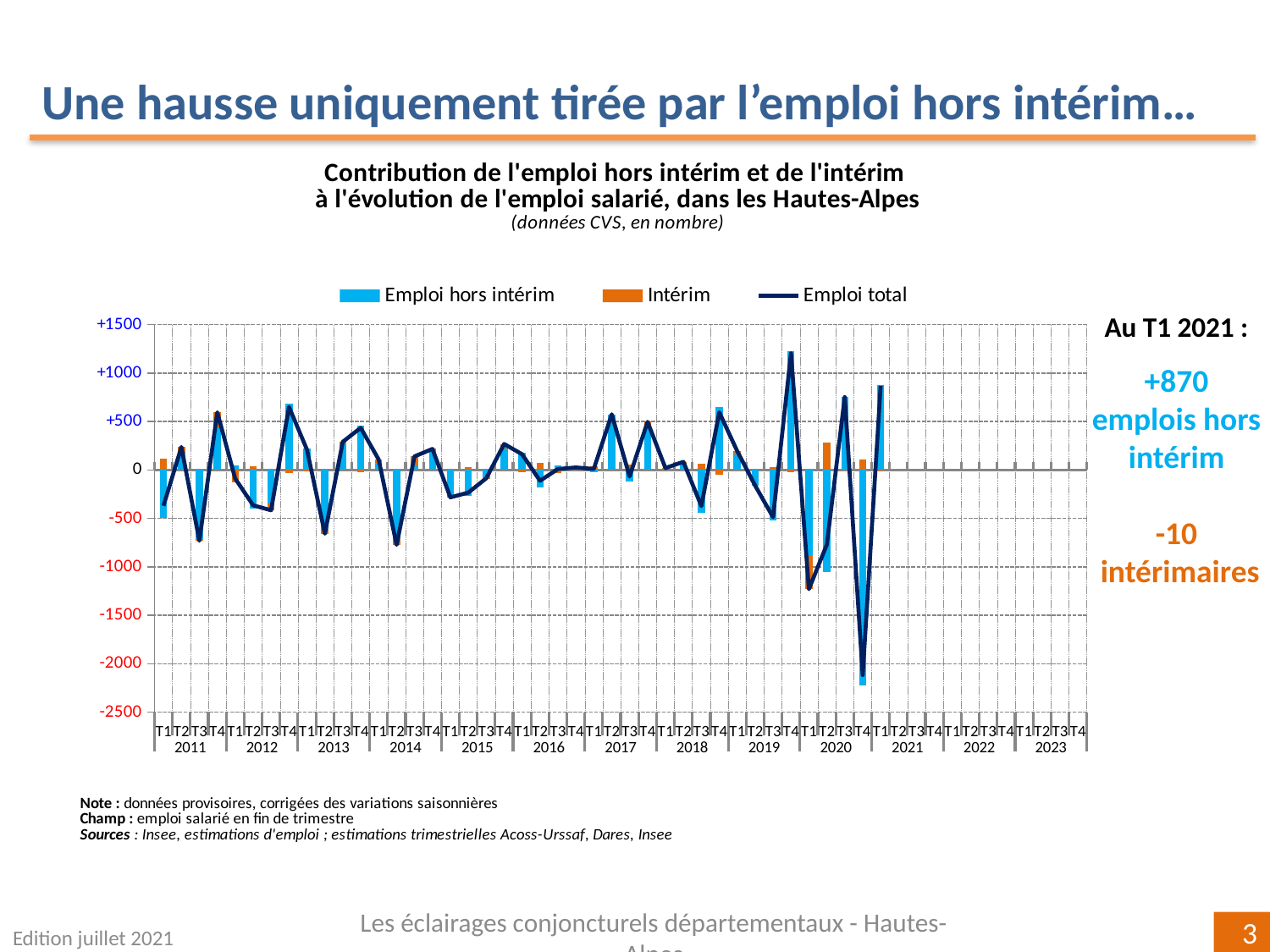
What is the value of Intérim at T1 2021? -10 At T1 2021, which is larger: the Emploi hors intérim value or the Intérim value? Emploi hors intérim What are the three series listed in the chart legend? Emploi hors intérim, Intérim, Emploi total What kind of chart is shown on the slide? A combined bar and line chart What is the value of Emploi hors intérim at T1 2021? +870 What is the title of the chart? Contribution de l'emploi hors intérim et de l'intérim à l'évolution de l'emploi salarié, dans les Hautes-Alpes In which quarter does the Emploi total line reach its lowest point? T4 2020 In which quarter does the Emploi total line reach its highest point? T4 2019 Is the Emploi total value for T4 2019 greater or less than +1000? greater How many years are labelled along the x axis of the chart? 13 Is the Emploi total value for T4 2020 greater or less than -1500? less How many series does the chart legend list? 3